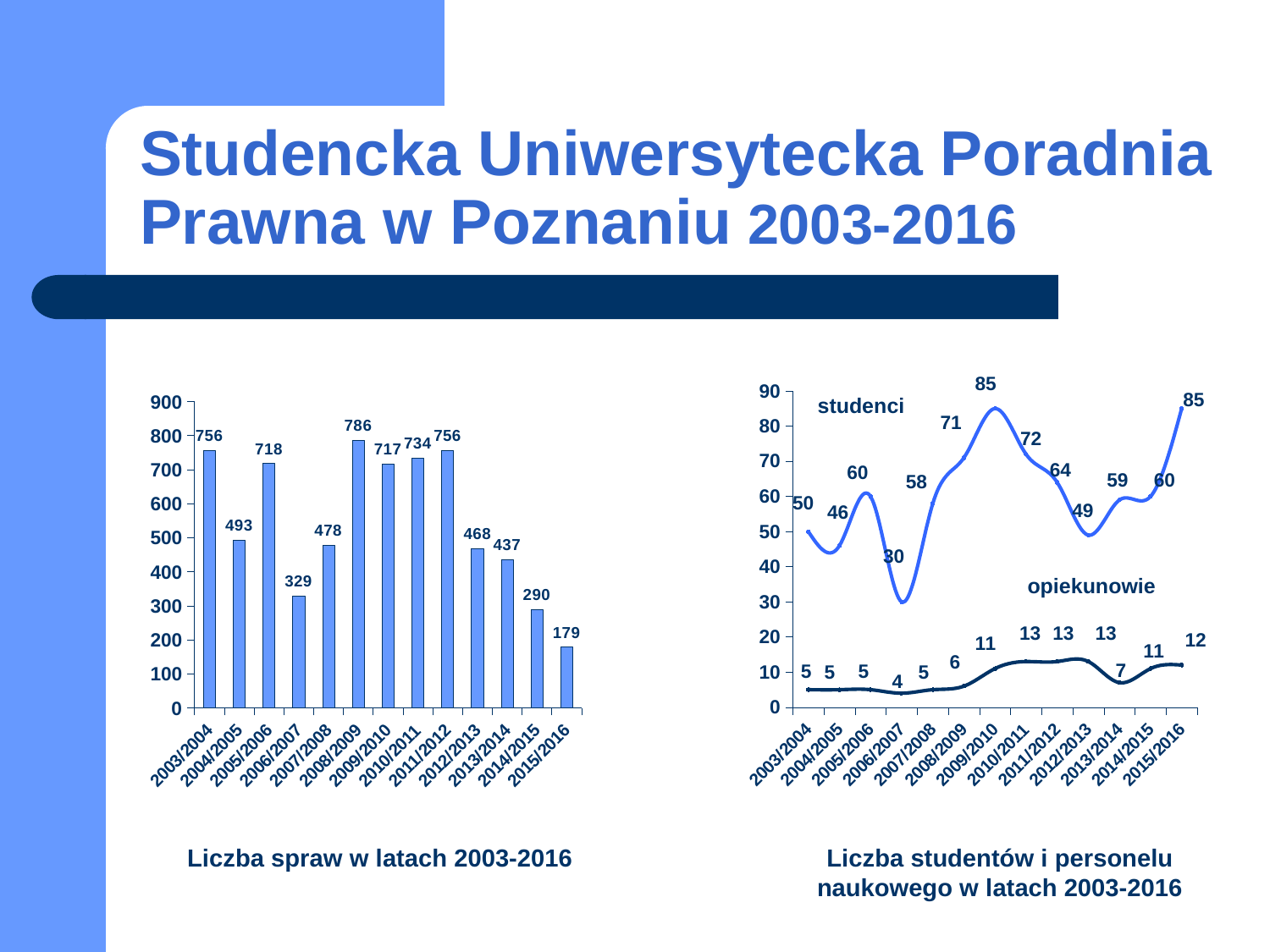
In the chart 'Liczba spraw w latach 2003-2016', what is the difference between the values for 2003/2004 and 2004/2005? 263 In the chart 'Liczba spraw w latach 2003-2016', which year has the highest value? 2008/2009 In the chart 'Liczba spraw w latach 2003-2016', which year has the lowest value? 2015/2016 In the chart 'Liczba studentów i personelu naukowego w latach 2003-2016', what is the value for opiekunowie in 2013/2014? 7 In the chart 'Liczba studentów i personelu naukowego w latach 2003-2016', what is the difference between studenci and opiekunowie in 2009/2010? 74 What kind of chart is 'Liczba studentów i personelu naukowego w latach 2003-2016'? Line chart In the chart 'Liczba studentów i personelu naukowego w latach 2003-2016', in which year is the value for opiekunowie lowest? 2006/2007 In the chart 'Liczba spraw w latach 2003-2016', which is larger, the value for 2006/2007 or the value for 2007/2008? 2007/2008 In the chart 'Liczba spraw w latach 2003-2016', how many years are shown on the x axis? 13 In the chart 'Liczba studentów i personelu naukowego w latach 2003-2016', what is the value for studenci in 2006/2007? 30 What kind of chart is 'Liczba spraw w latach 2003-2016'? Bar chart In the chart 'Liczba spraw w latach 2003-2016', what is the value for 2008/2009? 786